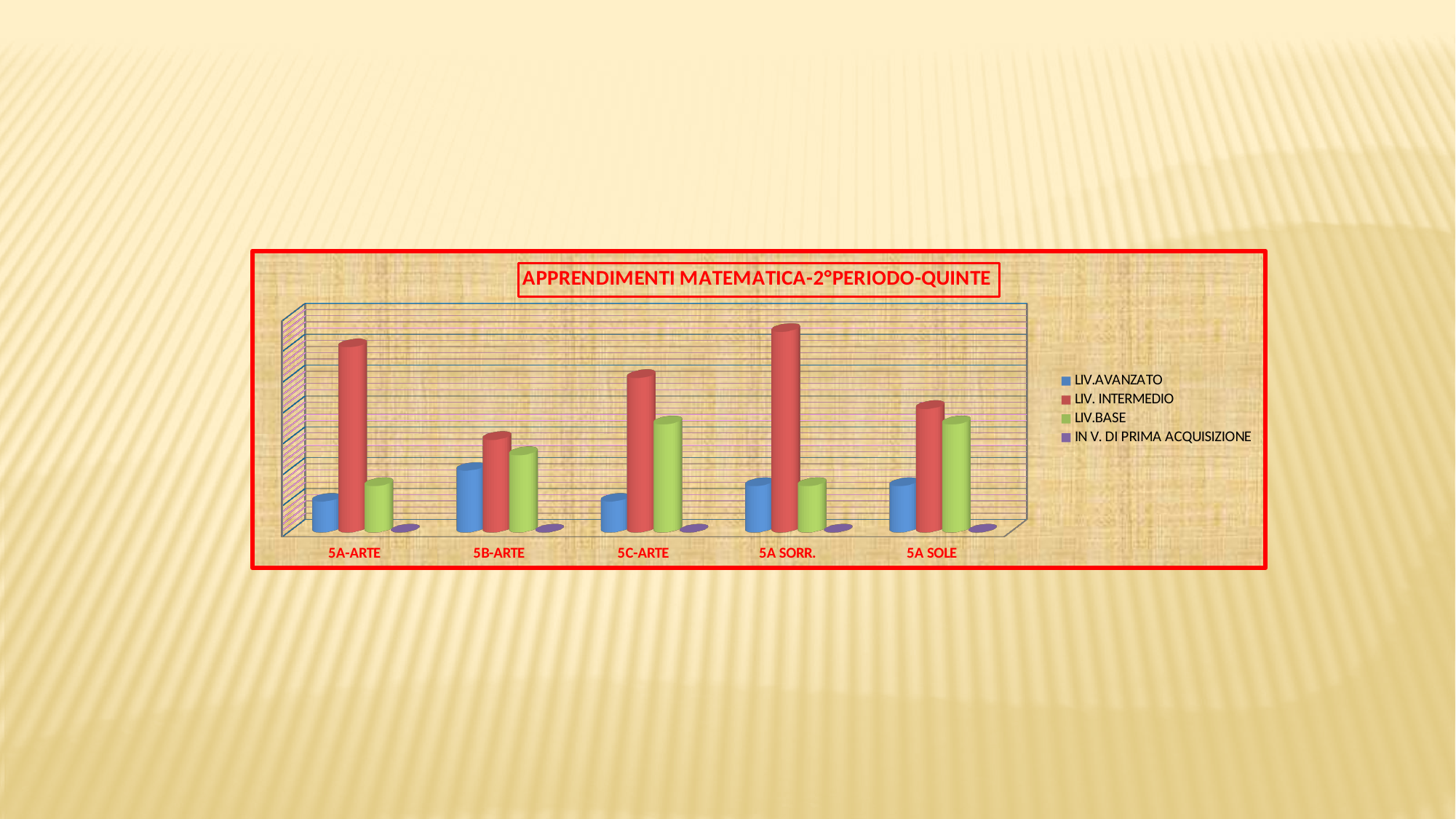
Which series is shown in red? LIV. INTERMEDIO Which class has the highest LIV. INTERMEDIO bar? 5A SORR. What kind of chart is shown on the slide? Bar chart How many classes (categories) are shown on the x axis? 5 Which series has the lowest bars across all classes? IN V. DI PRIMA ACQUISIZIONE Which class has the lowest LIV. INTERMEDIO bar? 5B-ARTE Is the LIV.BASE bar larger for 5C-ARTE or for 5A-ARTE? 5C-ARTE Which series has the tallest bar for 5A-ARTE? LIV. INTERMEDIO Is the LIV.AVANZATO bar larger for 5B-ARTE or for 5C-ARTE? 5B-ARTE How many series does the legend list? 4 Which class has the highest LIV.AVANZATO bar? 5B-ARTE What is the title of the chart? APPRENDIMENTI MATEMATICA-2°PERIODO-QUINTE